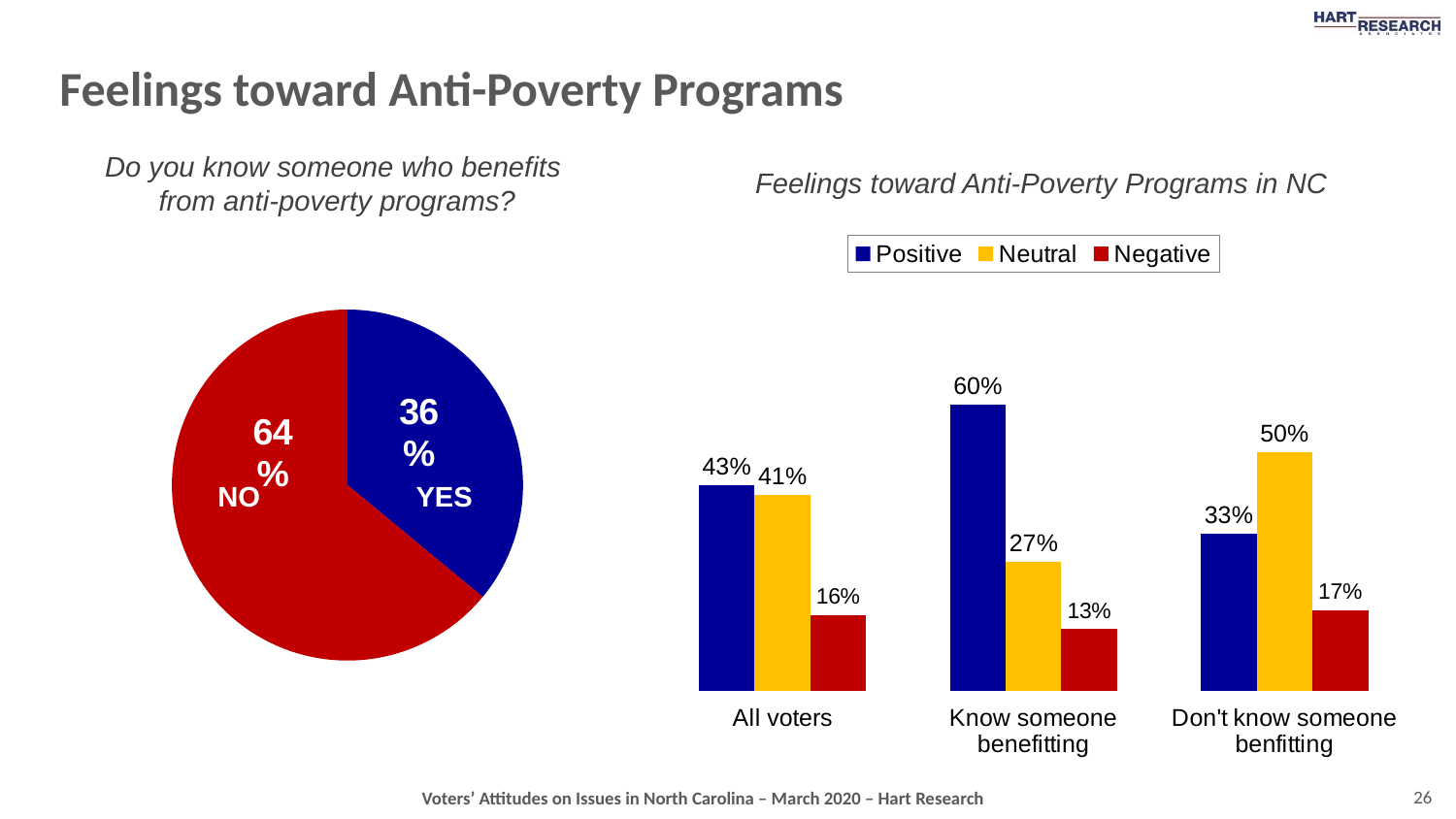
What kind of chart is the chart on the left of the slide? Pie chart In the pie chart on the left, which slice is larger, YES or NO? NO In 'Feelings toward Anti-Poverty Programs in NC', what is the Neutral value for 'Don't know someone benfitting'? 50% What kind of chart is 'Feelings toward Anti-Poverty Programs in NC'? Bar chart In 'Feelings toward Anti-Poverty Programs in NC', which category has the lowest Negative value? Know someone benefitting In the pie chart on the left, what percentage of respondents answered YES? 36% In 'Feelings toward Anti-Poverty Programs in NC', what is the Positive value for 'Know someone benefitting'? 60% How many series does the legend of 'Feelings toward Anti-Poverty Programs in NC' list? 3 In the pie chart on the left, what percentage of respondents answered NO? 64% In 'Feelings toward Anti-Poverty Programs in NC', which category has the highest Positive value? Know someone benefitting In 'Feelings toward Anti-Poverty Programs in NC', what is the difference between the Positive values for 'Know someone benefitting' and 'Don't know someone benfitting'? 27% In 'Feelings toward Anti-Poverty Programs in NC', what is the Negative value for 'All voters'? 16%